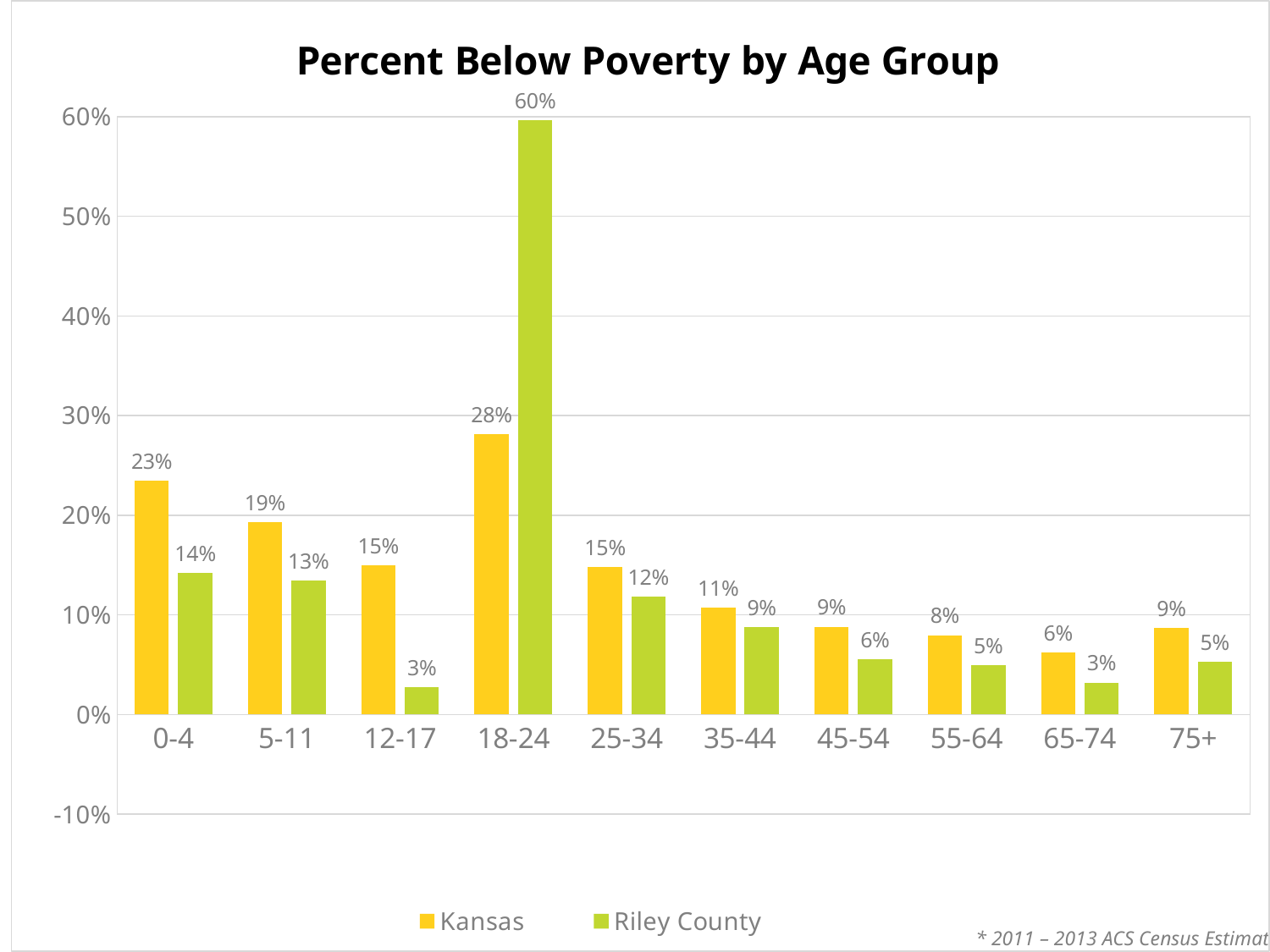
Which age group has the lowest Kansas value? 65-74 What is the Kansas value for the 0-4 age group? 23% How many series does the legend list? 2 What is the Kansas value for the 18-24 age group? 28% Which is larger for the 5-11 age group, the Kansas value or the Riley County value? Kansas How many age groups are shown on the x axis? 10 Which age group has the highest Riley County value? 18-24 What is the difference between the Riley County and Kansas values for the 18-24 age group? 32% Is the Riley County value for the 18-24 age group greater or less than 50%? greater What is the title of the chart? Percent Below Poverty by Age Group What kind of chart is shown on the slide? Bar chart What is the Riley County value for the 12-17 age group? 3%